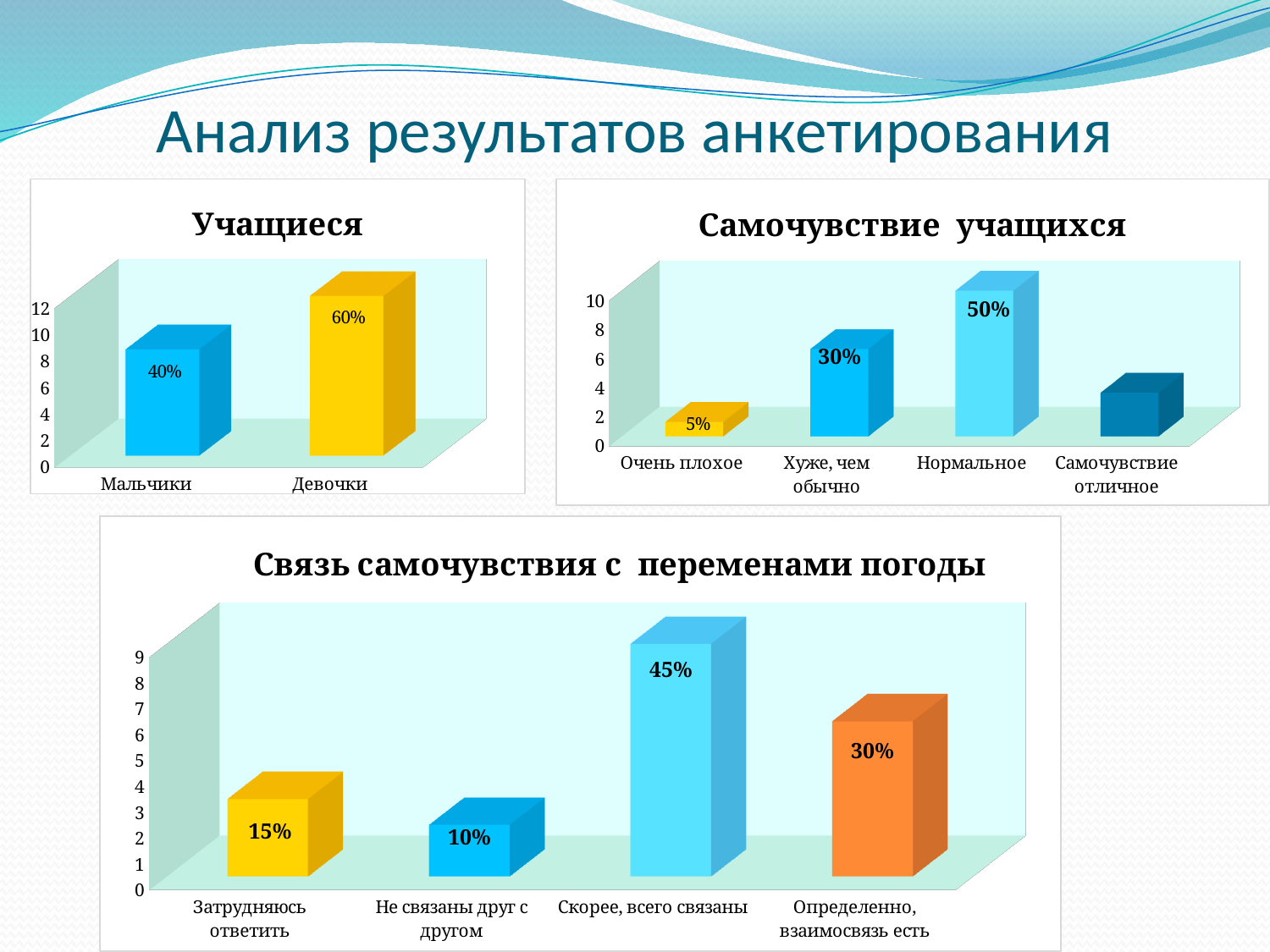
In the chart titled "Самочувствие учащихся", is the bar for Самочувствие отличное greater or less than 4 on the axis? less In the chart titled "Связь самочувствия с переменами погоды", which is larger: the value for Затрудняюсь ответить or the value for Определенно, взаимосвязь есть? Определенно, взаимосвязь есть In the chart titled "Связь самочувствия с переменами погоды", what is the difference between the values for Скорее, всего связаны and Определенно, взаимосвязь есть? 15% In the chart titled "Учащиеся", what is the value shown for Девочки? 60% In the chart titled "Связь самочувствия с переменами погоды", what is the value shown for Скорее, всего связаны? 45% In the chart titled "Самочувствие учащихся", what is the value shown for Хуже, чем обычно? 30% In the chart titled "Связь самочувствия с переменами погоды", which category has the lowest value? Не связаны друг с другом In the chart titled "Учащиеся", what is the difference between the values for Девочки and Мальчики? 20% In the chart titled "Учащиеся", which category has the lower value? Мальчики In the chart titled "Самочувствие учащихся", how many categories are shown on the x axis? 4 In the chart titled "Самочувствие учащихся", which category has the highest value? Нормальное What kind of chart is the chart titled "Связь самочувствия с переменами погоды"? Bar chart